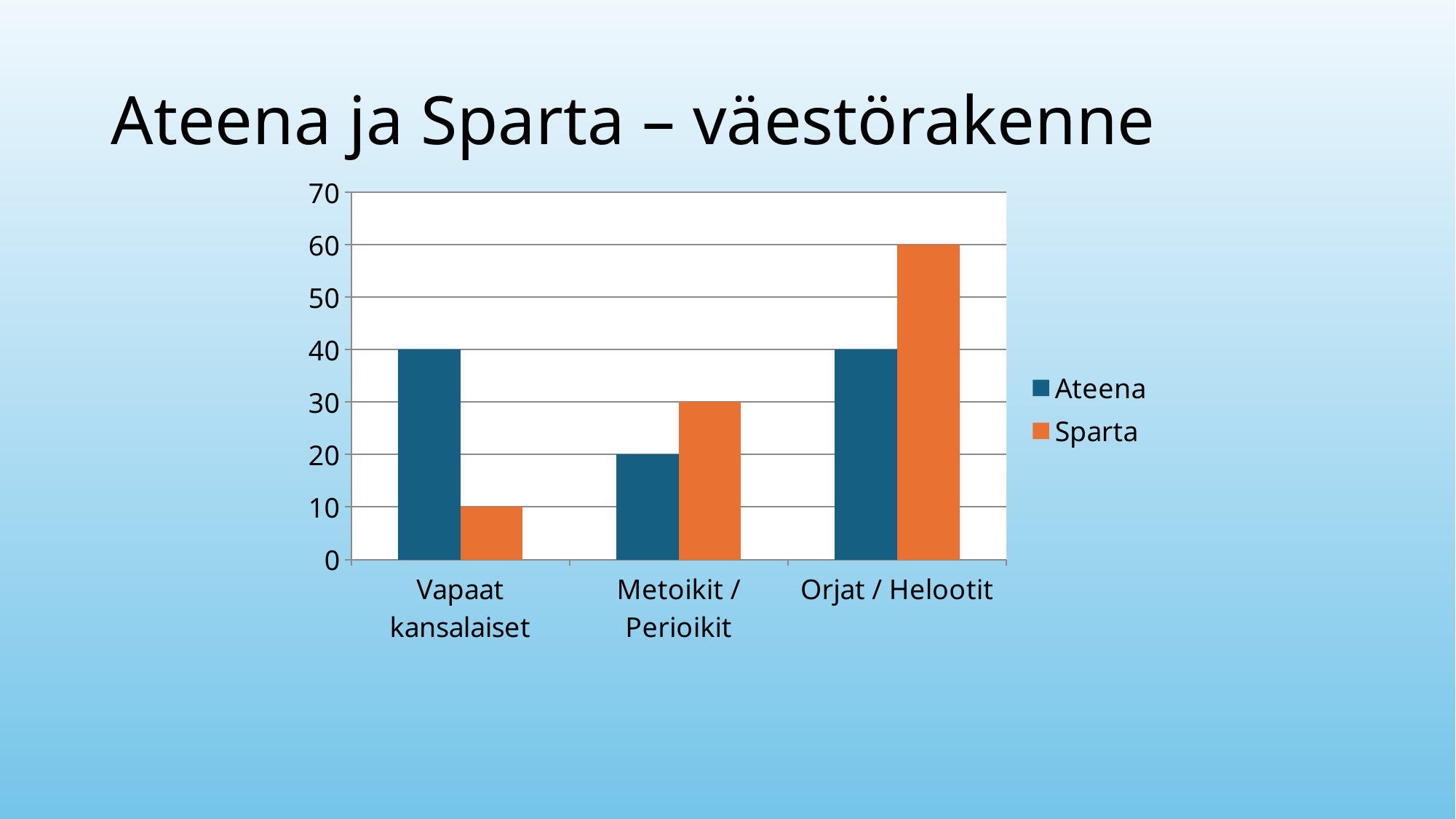
What kind of chart is shown on the slide? Bar chart Which category has the lowest value for Sparta? Vapaat kansalaiset In the Vapaat kansalaiset category, which is larger, Ateena or Sparta? Ateena Do the Sparta values rise or fall from left to right along the x axis? Rise How many categories are shown on the x axis? 3 What is the value for Sparta in the Orjat / Helootit category? 60 What is the value for Ateena in the Vapaat kansalaiset category? 40 What is the difference between the Sparta and Ateena values in the Orjat / Helootit category? 20 What is the value for Sparta in the Metoikit / Perioikit category? 30 Which category has the highest value for Sparta? Orjat / Helootit What is the value for Ateena in the Metoikit / Perioikit category? 20 How many series does the legend list? 2